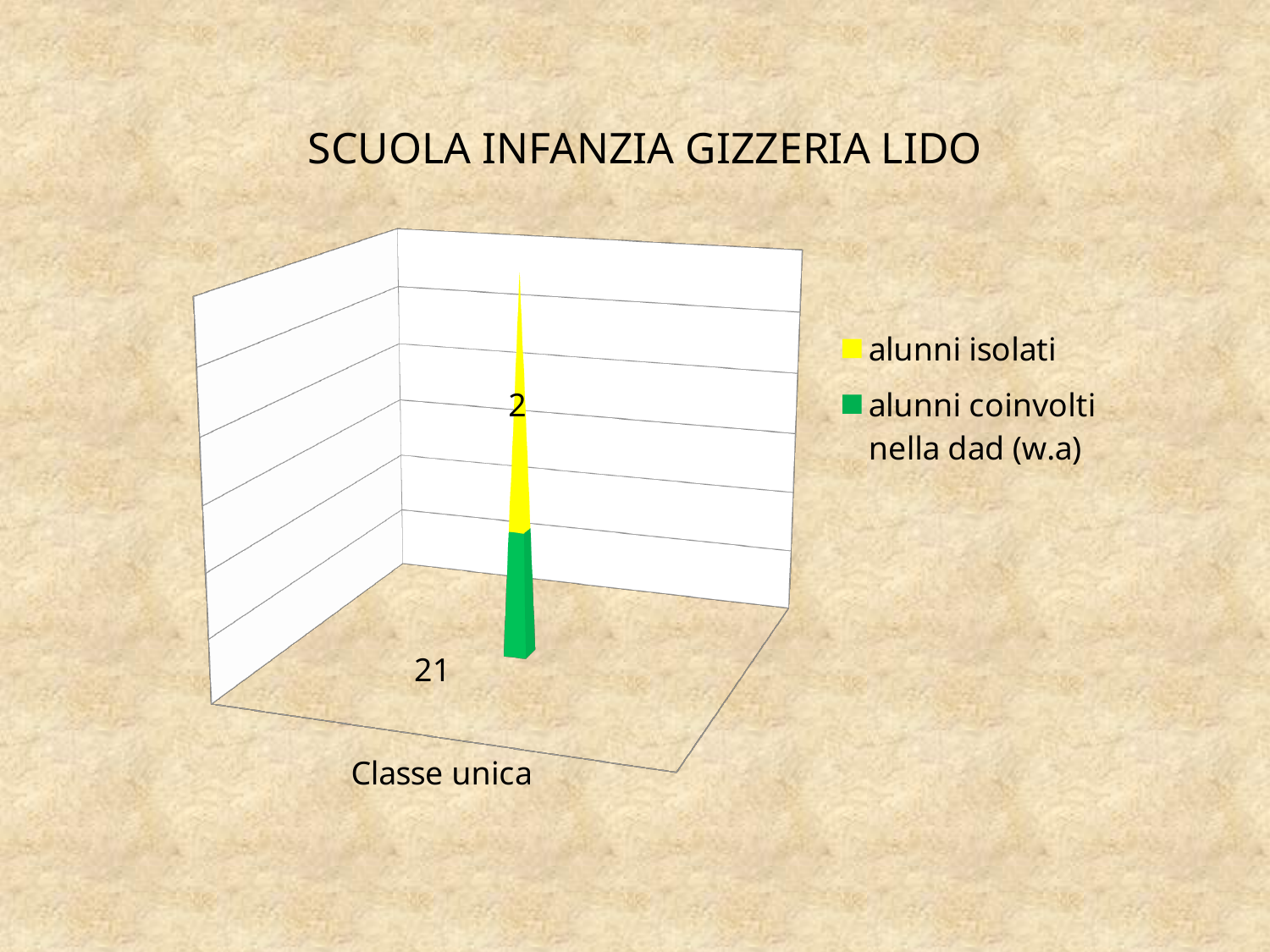
Is the value for alunni isolati larger or smaller than the value for alunni coinvolti nella dad (w.a)? smaller What is the difference between alunni coinvolti nella dad (w.a) and alunni isolati? 19 What is the title of the chart? SCUOLA INFANZIA GIZZERIA LIDO What is the total of the stacked bar for Classe unica? 23 Which colour represents alunni isolati in the legend? yellow What kind of chart is shown on the slide? bar chart How many series does the legend list? 2 Which series has the higher value for Classe unica? alunni coinvolti nella dad (w.a) How many categories are shown on the x axis? 1 Which series has the lower value for Classe unica? alunni isolati What is the value for alunni isolati in Classe unica? 2 What is the value for alunni coinvolti nella dad (w.a) in Classe unica? 21